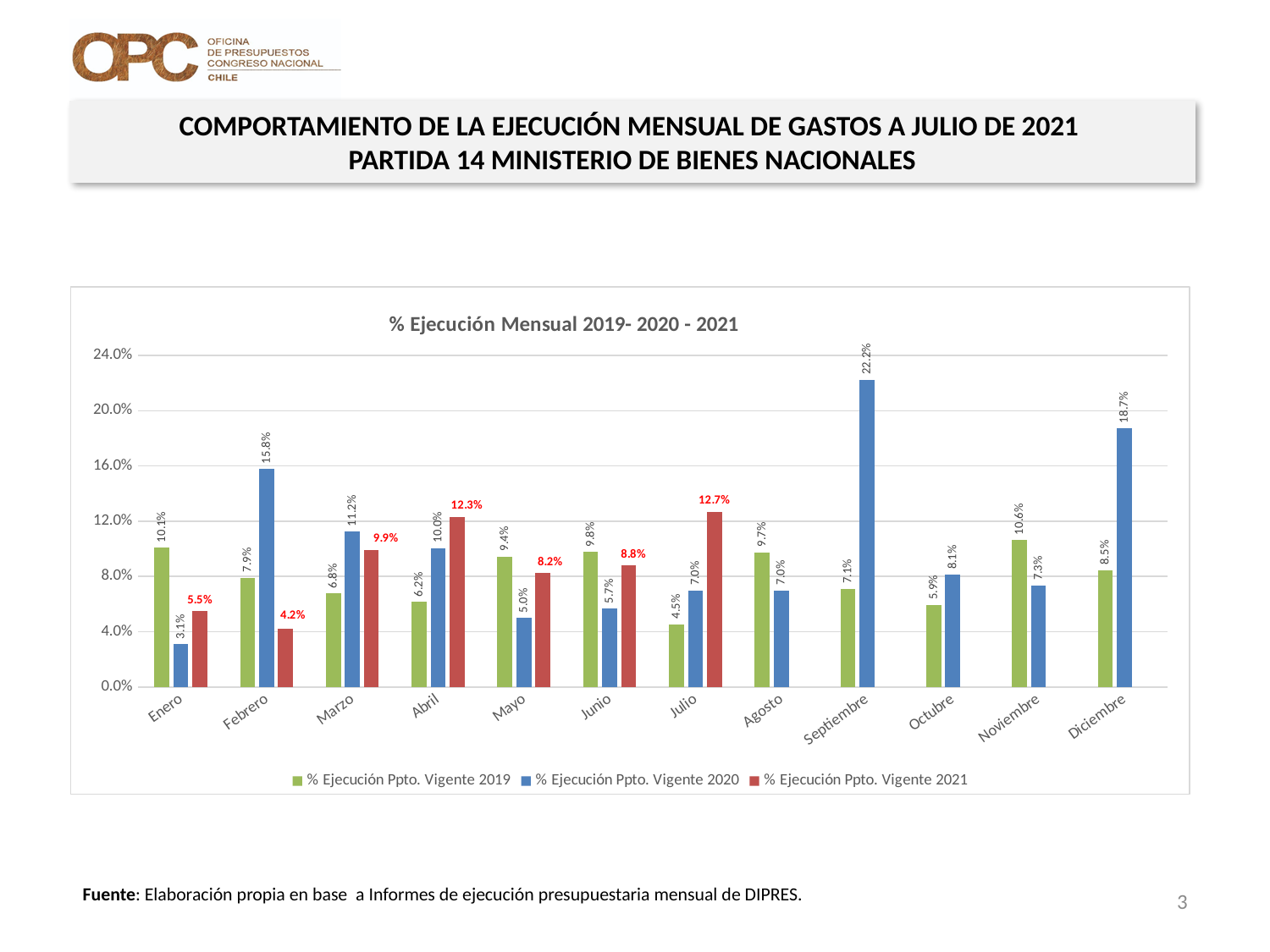
What type of chart is shown on the slide? Bar chart What is the title of the chart? % Ejecución Mensual 2019- 2020 - 2021 Is the value for % Ejecución Ppto. Vigente 2020 in Diciembre greater or less than 16.0%? greater In which month is the % Ejecución Ppto. Vigente 2020 value highest? Septiembre In which month is the % Ejecución Ppto. Vigente 2021 value lowest? Febrero What is the value for % Ejecución Ppto. Vigente 2020 in Septiembre? 22.2% Which is larger in Abril: the 2021 value or the 2019 value? 2021 value (12.3%) How many series does the legend list? 3 What is the difference between the 2020 and 2019 values in Febrero? 7.9% How many months are shown on the x axis? 12 What is the value for % Ejecución Ppto. Vigente 2021 in Julio? 12.7% What is the value for % Ejecución Ppto. Vigente 2019 in Noviembre? 10.6%